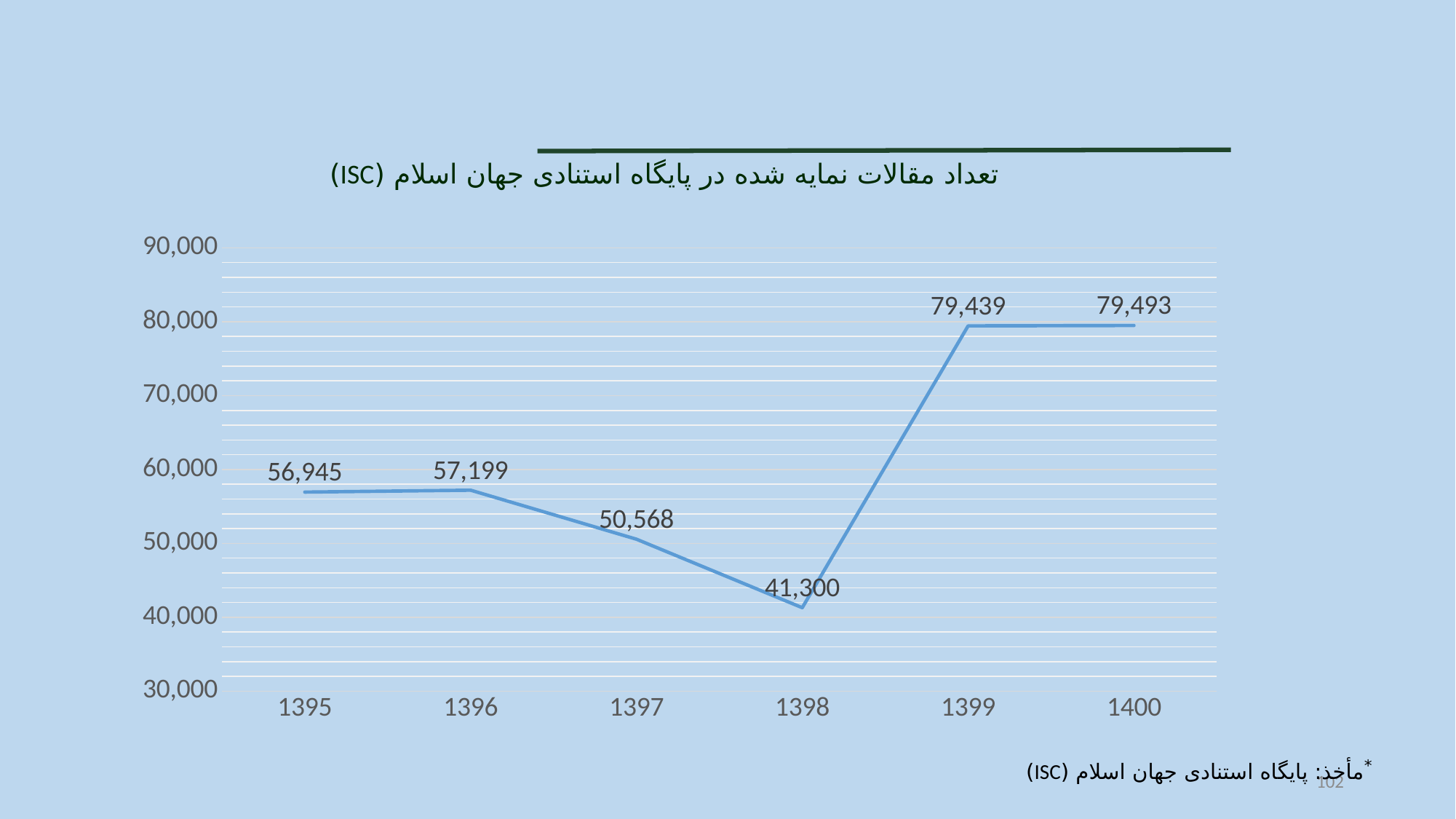
What is the difference between the values for 1399 and 1398? 38,139 Is the value for 1399 greater or less than 70,000? greater What is the value for 1395? 56,945 What is the difference between the values for 1396 and 1395? 254 What kind of chart is shown? line chart Does the value rise or fall from 1396 to 1398? fall What is the value for 1398? 41,300 How many years are plotted on the x axis? 6 Which year has the lowest value? 1398 Which year has the highest value? 1400 What is the value for 1400? 79,493 Which is larger, the value for 1397 or the value for 1398? 1397